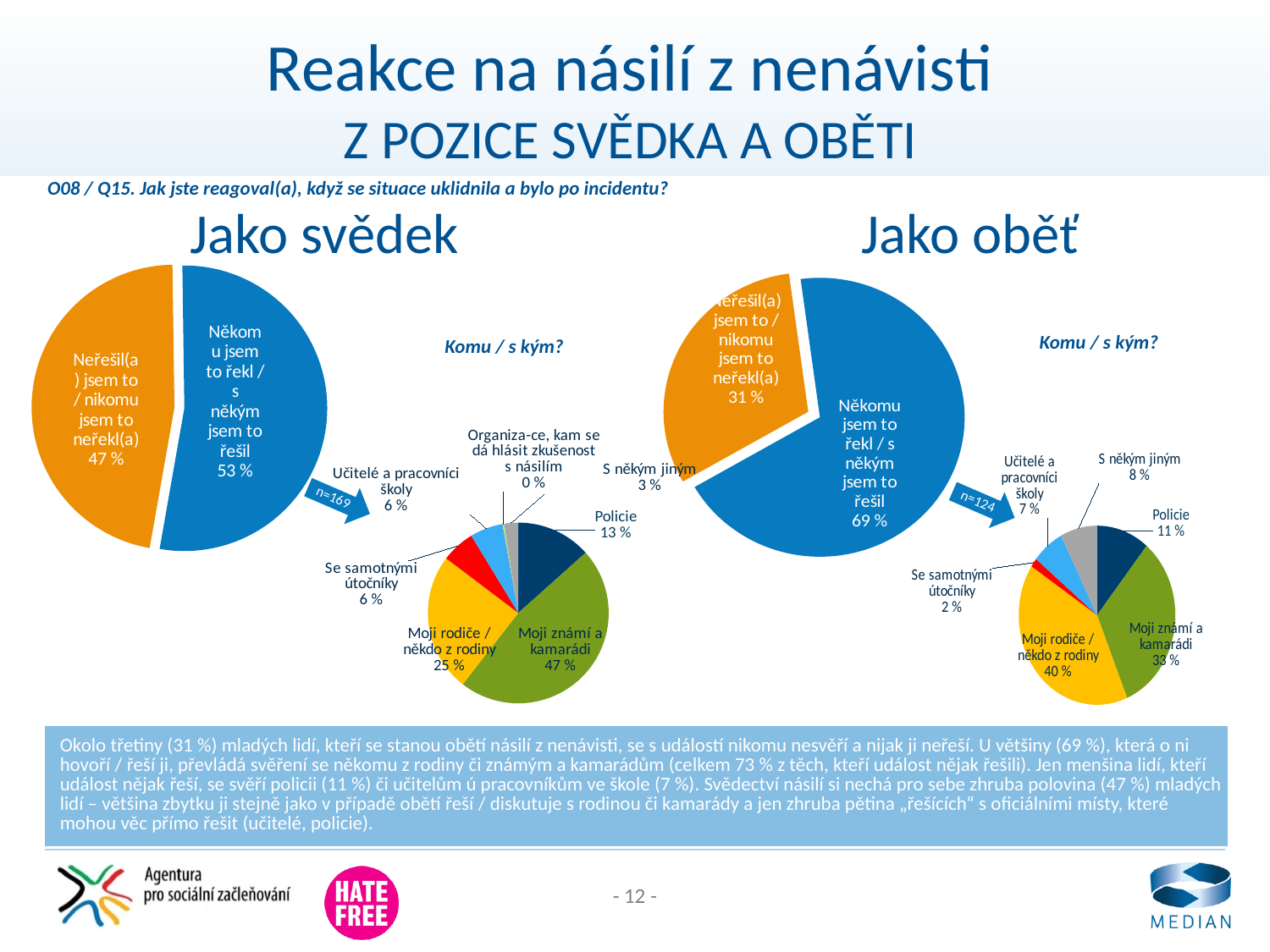
In the large 'Jako oběť' pie chart on the right, what is the value for 'Někomu jsem to řekl / s někým jsem to řešil'? 69 % In the small 'Komu / s kým?' pie chart under 'Jako oběť', what is the value for 'Moji rodiče / někdo z rodiny'? 40 % In the large 'Jako svědek' pie chart on the left, what is the value for 'Neřešil(a) jsem to / nikomu jsem to neřekl(a)'? 47 % In the large 'Jako oběť' pie chart on the right, what is the difference between the two slices? 38 % In the small 'Komu / s kým?' pie chart under 'Jako svědek', what is the value for 'Policie'? 13 % In the small 'Komu / s kým?' pie chart under 'Jako svědek', what is the difference between 'Moji známí a kamarádi' and 'Moji rodiče / někdo z rodiny'? 22 % How many categories are shown in the small 'Komu / s kým?' pie chart under 'Jako svědek'? 7 In the small 'Komu / s kým?' pie chart under 'Jako svědek', which category has the highest value? Moji známí a kamarádi What is the sample size (n) shown on the arrow for the 'Jako oběť' chart? n=124 What type of chart is used for 'Jako svědek' on the left? Pie chart In the small 'Komu / s kým?' pie chart under 'Jako oběť', which category has the lowest value? Se samotnými útočníky In the small 'Komu / s kým?' pie chart under 'Jako oběť', which is larger: 'Policie' or 'S někým jiným'? Policie